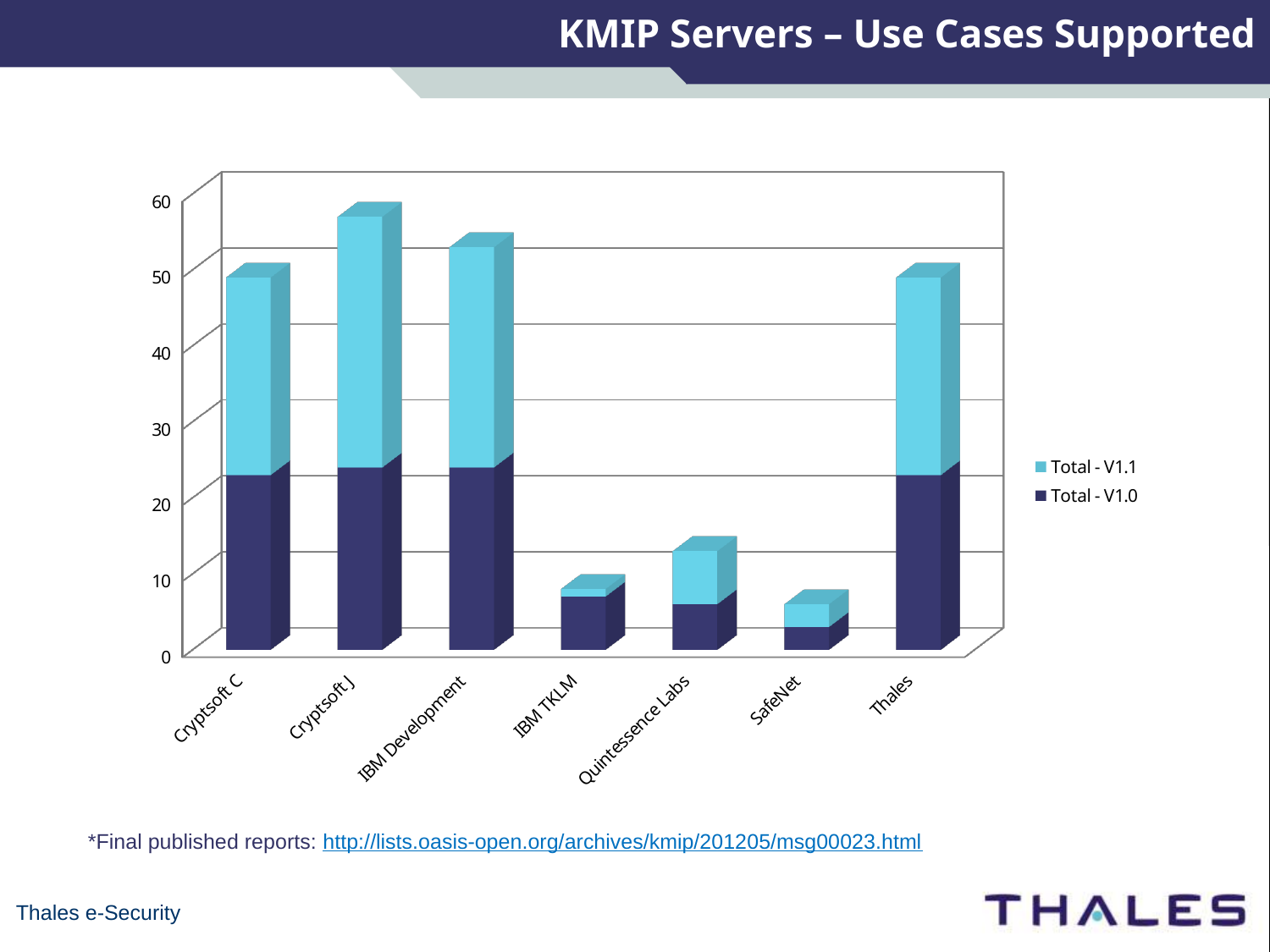
Which has the taller total bar, Cryptsoft C or IBM TKLM? Cryptsoft C Which server has the lowest total bar? SafeNet How many series does the legend list? 2 Is the total bar for IBM TKLM greater or less than 10? less Is the total bar for Cryptsoft J greater or less than 50? greater Is the total bar for Quintessence Labs greater or less than 20? less What are the two series named in the legend? Total - V1.1 and Total - V1.0 Which has the taller total bar, Thales or SafeNet? Thales Which server has the highest total bar? Cryptsoft J How many KMIP servers (categories) are shown on the x axis? 7 What kind of chart is shown on the slide? Stacked bar chart